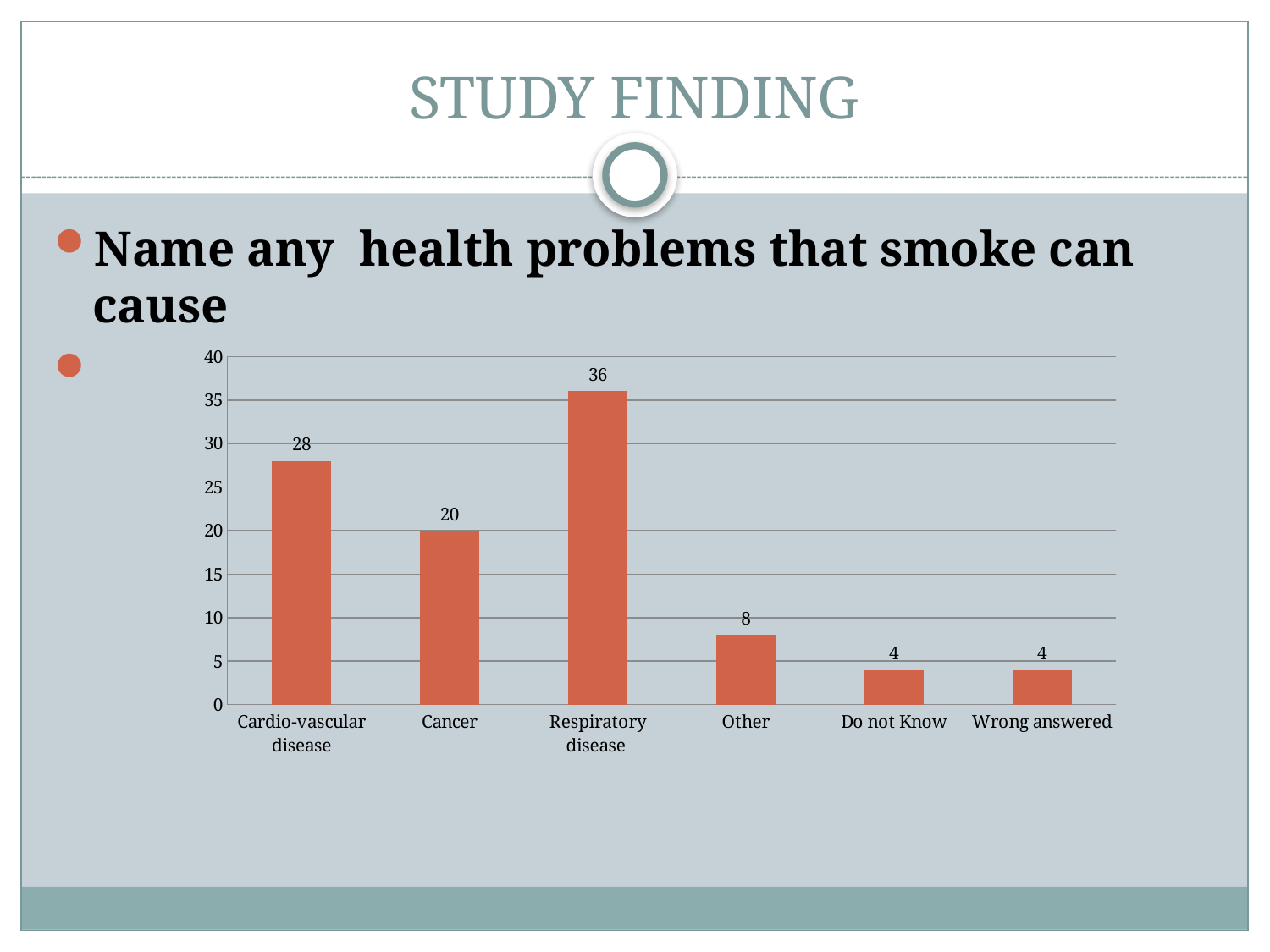
What is the value for Other? 8 Which category has the highest value? Respiratory disease What is the value for Cardio-vascular disease? 28 How many categories are shown on the x axis? 6 Is the value for Respiratory disease greater or less than 30? greater What is the difference between the values for Respiratory disease and Cardio-vascular disease? 8 What is the value for Respiratory disease? 36 Which is larger, the value for Cardio-vascular disease or the value for Cancer? Cardio-vascular disease What is the difference between the values for Cancer and Other? 12 What is the value for Do not Know? 4 What kind of chart is shown on the slide? bar chart What is the value for Cancer? 20